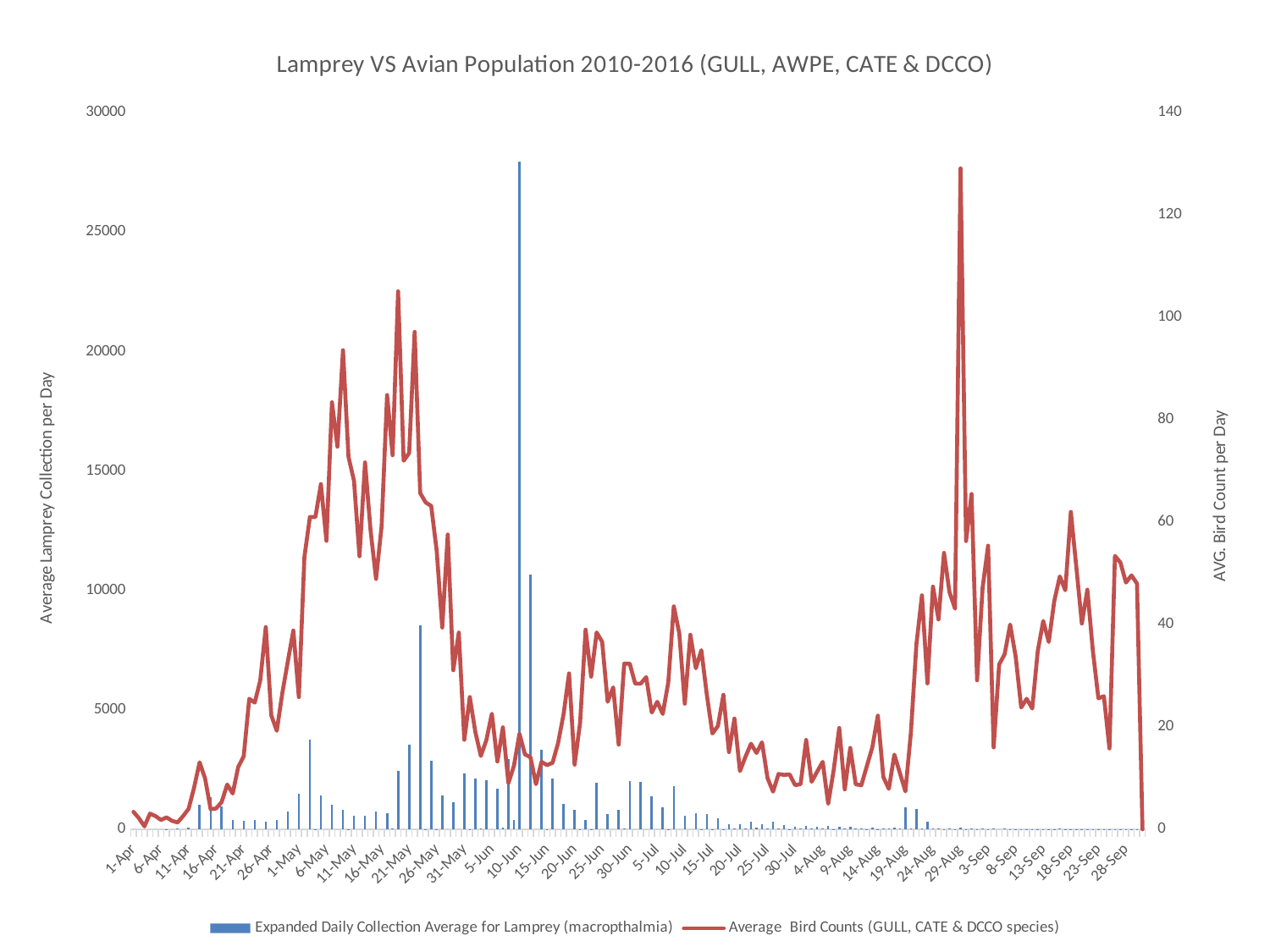
What kind of chart is this? A combination bar and line chart Is the lamprey collection bar around 1-May greater or less than 5000? less Around which date does the Expanded Daily Collection Average for Lamprey reach its highest value? 10-Jun Is the tallest lamprey collection bar (around 10-Jun) greater or less than 25000? greater Is the average bird count around 30-Jul greater or less than 20? less Does the Average Bird Counts line generally rise or fall between 1-Apr and 6-May? Rise What is the title of the chart? Lamprey VS Avian Population 2010-2016 (GULL, AWPE, CATE & DCCO) Around which date does the Average Bird Counts line reach its highest value? 29-Aug What is the label of the left vertical axis? Average Lamprey Collection per Day Which is larger: the bird count peak around 29-Aug or the bird count peak around 21-May? The peak around 29-Aug How many series does the legend list? 2